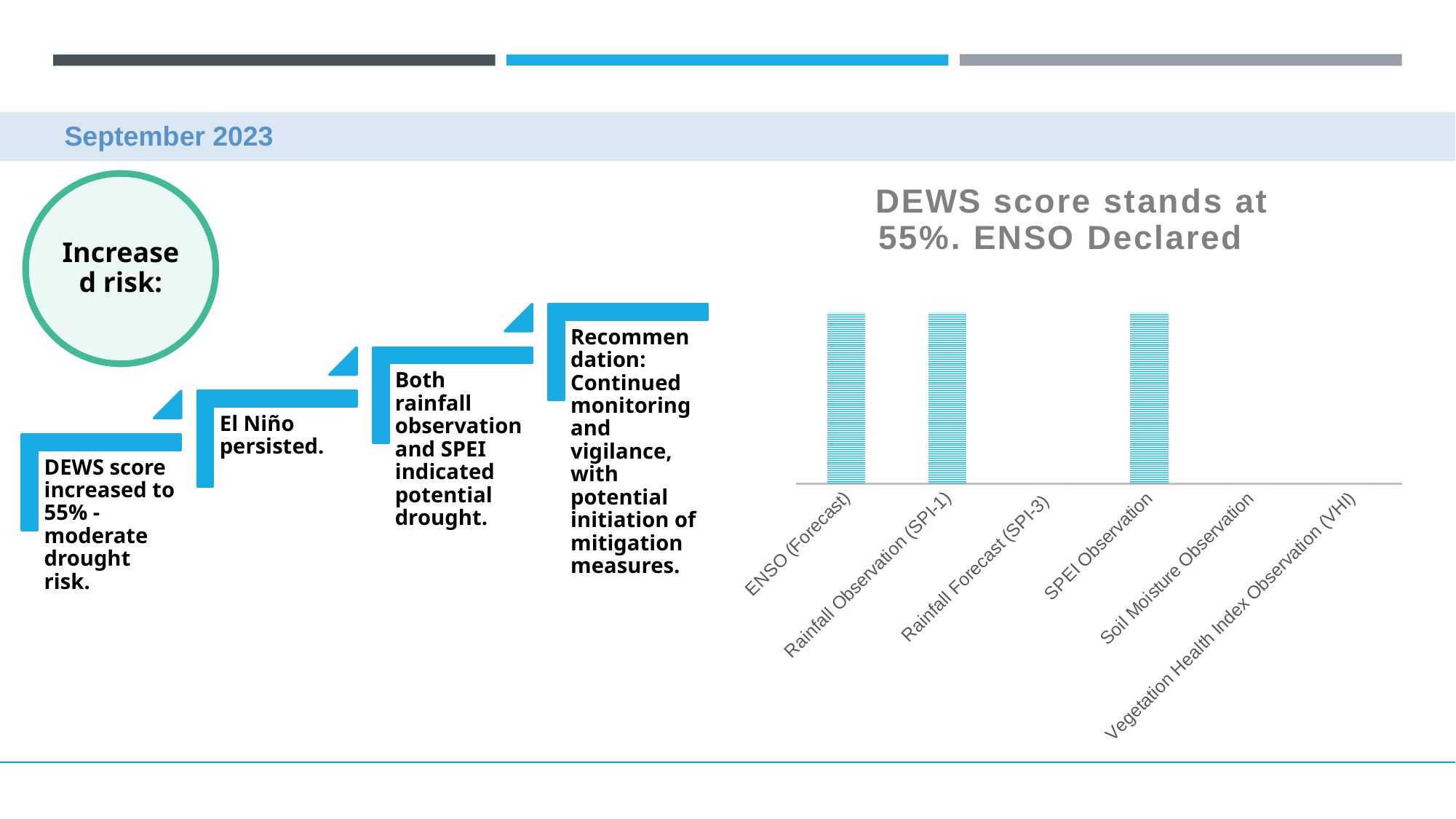
Which is larger in the chart, the value for SPEI Observation or the value for Soil Moisture Observation? SPEI Observation What is the title of the chart on the slide? DEWS score stands at 55%. ENSO Declared How many categories are listed along the x axis of the chart? 6 What is the label of the last category on the x axis of the chart? Vegetation Health Index Observation (VHI) What kind of chart is shown on the right of the slide? Bar chart Which is larger in the chart, the value for Rainfall Observation (SPI-1) or the value for Vegetation Health Index Observation (VHI)? Rainfall Observation (SPI-1) What is the label of the first category on the x axis of the chart? ENSO (Forecast) Which is larger in the chart, the value for ENSO (Forecast) or the value for Rainfall Forecast (SPI-3)? ENSO (Forecast) How many categories in the chart have a visible bar? 3 Which categories in the chart show no bar at all? Rainfall Forecast (SPI-3), Soil Moisture Observation, Vegetation Health Index Observation (VHI)